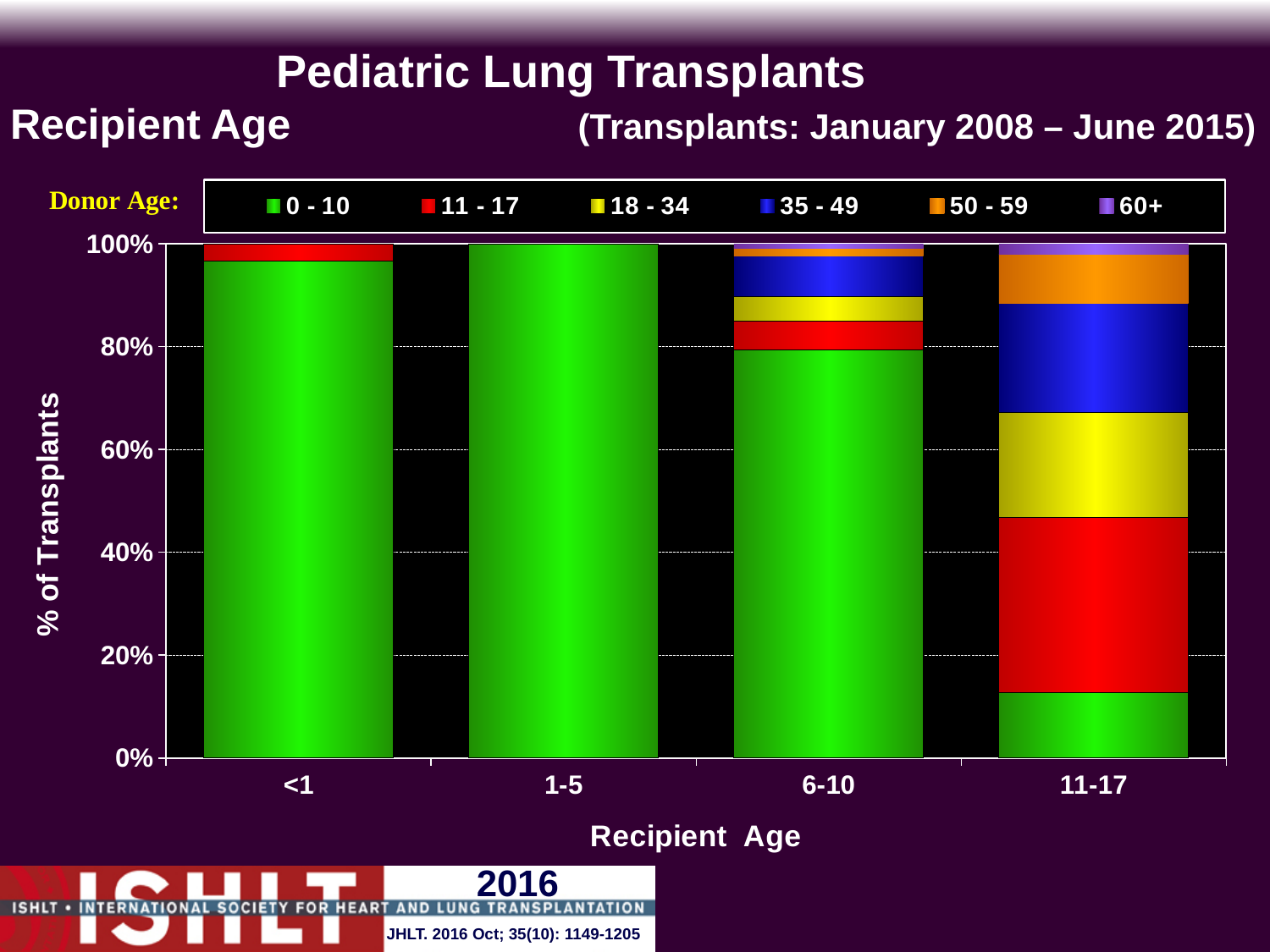
Which recipient age group has the smallest share of transplants from donors aged 0 - 10? 11-17 How many recipient age categories are shown on the x axis? 4 What is the title of the y axis? % of Transplants Is the share of transplants from donors aged 0 - 10 for recipients aged 6-10 greater or less than 60%? greater What percentage of transplants for recipients aged 1-5 came from donors aged 0 - 10? 100% What kind of chart is shown on the slide? stacked bar chart What is the total of the stacked bar for recipients aged 11-17? 100% Which recipient age group has the largest share of transplants from donors aged 0 - 10? 1-5 Is the share of transplants from donors aged 0 - 10 for recipients aged 11-17 greater or less than 20%? less How many donor age groups does the legend list? 6 What label is given to the legend on the chart? Donor Age: Which recipient age group has a larger share of transplants from donors aged 11 - 17: 6-10 or 11-17? 11-17